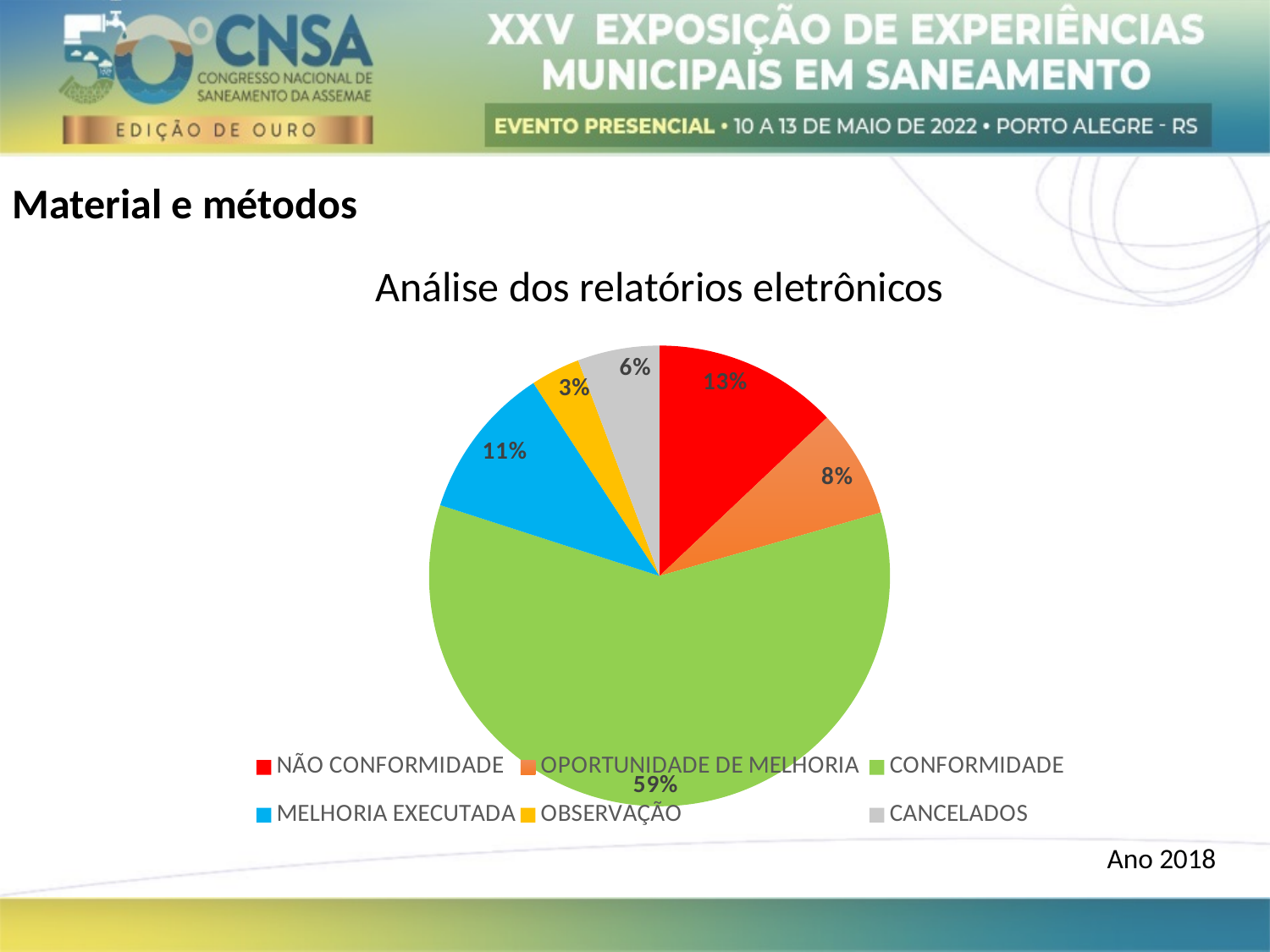
What kind of chart is shown on the slide? Pie chart What is the difference between the NÃO CONFORMIDADE and OPORTUNIDADE DE MELHORIA percentages? 5% Which category has the largest slice of the pie? CONFORMIDADE How many categories does the legend list? 6 What is the title of the chart? Análise dos relatórios eletrônicos Which category has the smallest slice of the pie? OBSERVAÇÃO What is the value shown for MELHORIA EXECUTADA? 11% What percentage of the pie does CONFORMIDADE represent? 59% What is the value shown for CANCELADOS? 6% Which is larger, MELHORIA EXECUTADA or CANCELADOS? MELHORIA EXECUTADA What is the value shown for OBSERVAÇÃO? 3% What is the value shown for NÃO CONFORMIDADE? 13%